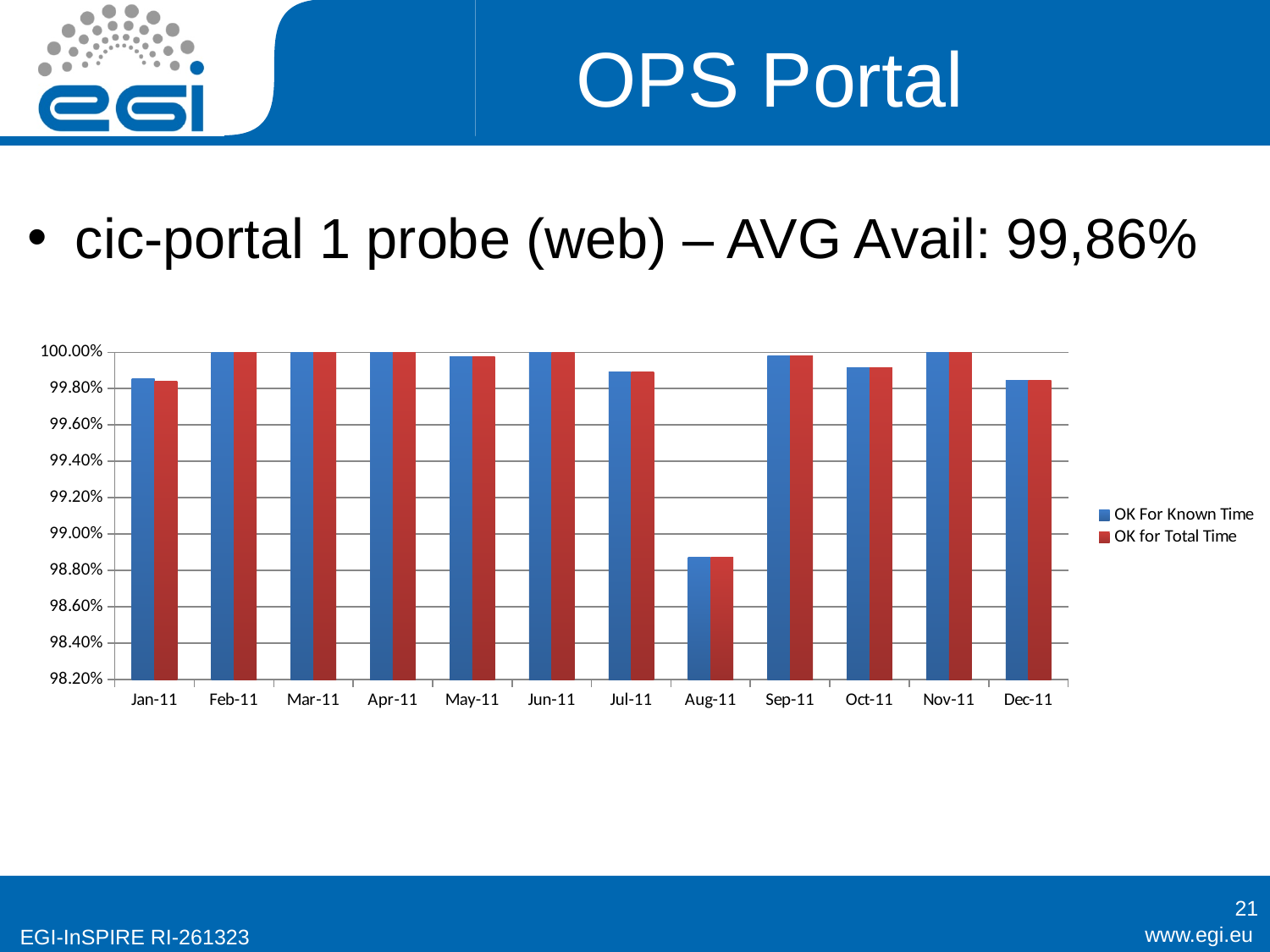
Which is larger, the 'OK For Known Time' value for Aug-11 or for Sep-11? Sep-11 What kind of chart is shown on the slide? bar chart Which is larger, the 'OK for Total Time' value for Jul-11 or for Aug-11? Jul-11 Is the 'OK For Known Time' value for Jul-11 greater or less than 99.80%? greater Is the 'OK For Known Time' value for Aug-11 greater or less than 99.00%? less Is the 'OK for Total Time' value for Oct-11 greater or less than 99.60%? greater What colour are the 'OK for Total Time' bars in the chart? red How many series does the chart legend list? 2 What are the two series named in the chart legend? OK For Known Time, OK for Total Time Which month has the lowest availability in the chart? Aug-11 How many months are shown on the x axis of the chart? 12